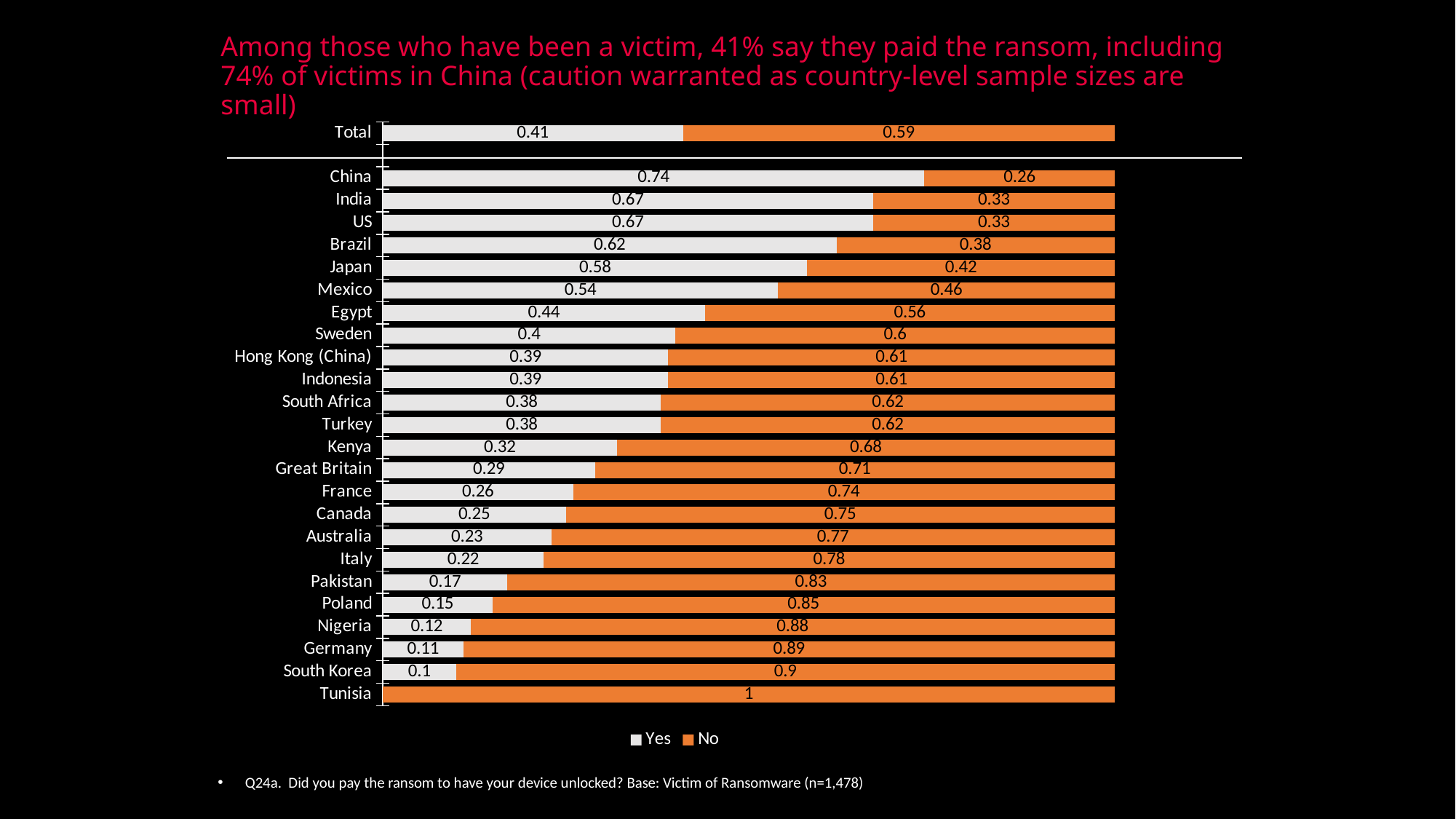
How many countries (excluding Total) are shown in the chart? 24 Which has a larger "Yes" value, Brazil or Mexico? Brazil What kind of chart is shown on the slide? Stacked bar chart What is the "No" value for Japan? 0.42 What is the "Yes" value for the Total bar? 0.41 What is the difference between the "Yes" values for China and Germany? 0.63 Which colour represents the "No" series in the chart? Orange What is the total of the stacked bar for Kenya? 1 What is the "Yes" value for China? 0.74 Which country has the lowest "No" value? China Which country has the highest "Yes" value? China How many series does the legend list? 2